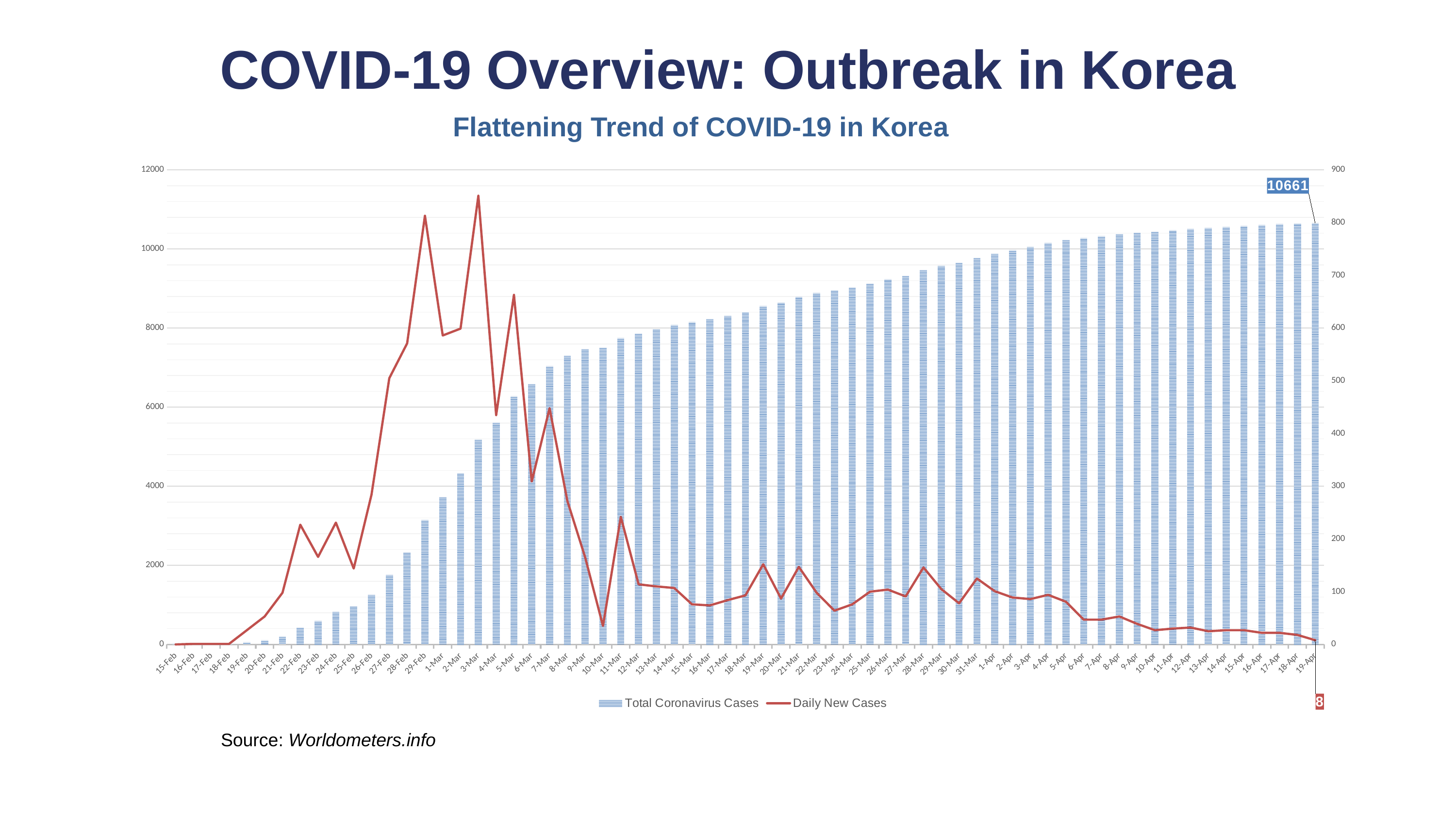
Is the value of Total Coronavirus Cases on 1-Apr greater or less than 8000? greater What is the value of Daily New Cases on 19-Apr? 8 On which date does the Daily New Cases line reach its highest point? 3-Mar How many dates are shown on the x axis? 65 What is the value of Total Coronavirus Cases on 19-Apr? 10661 Is the value of Daily New Cases on 10-Mar greater or less than 100? less What is the title of the chart? Flattening Trend of COVID-19 in Korea Is the value of Total Coronavirus Cases on 10-Mar greater or less than 6000? greater What are the two series named in the legend? Total Coronavirus Cases and Daily New Cases Do the Total Coronavirus Cases bars rise or fall from 15-Feb to 19-Apr? Rise How many series does the legend list? 2 What kind of chart is shown on the slide? A bar chart combined with a line chart